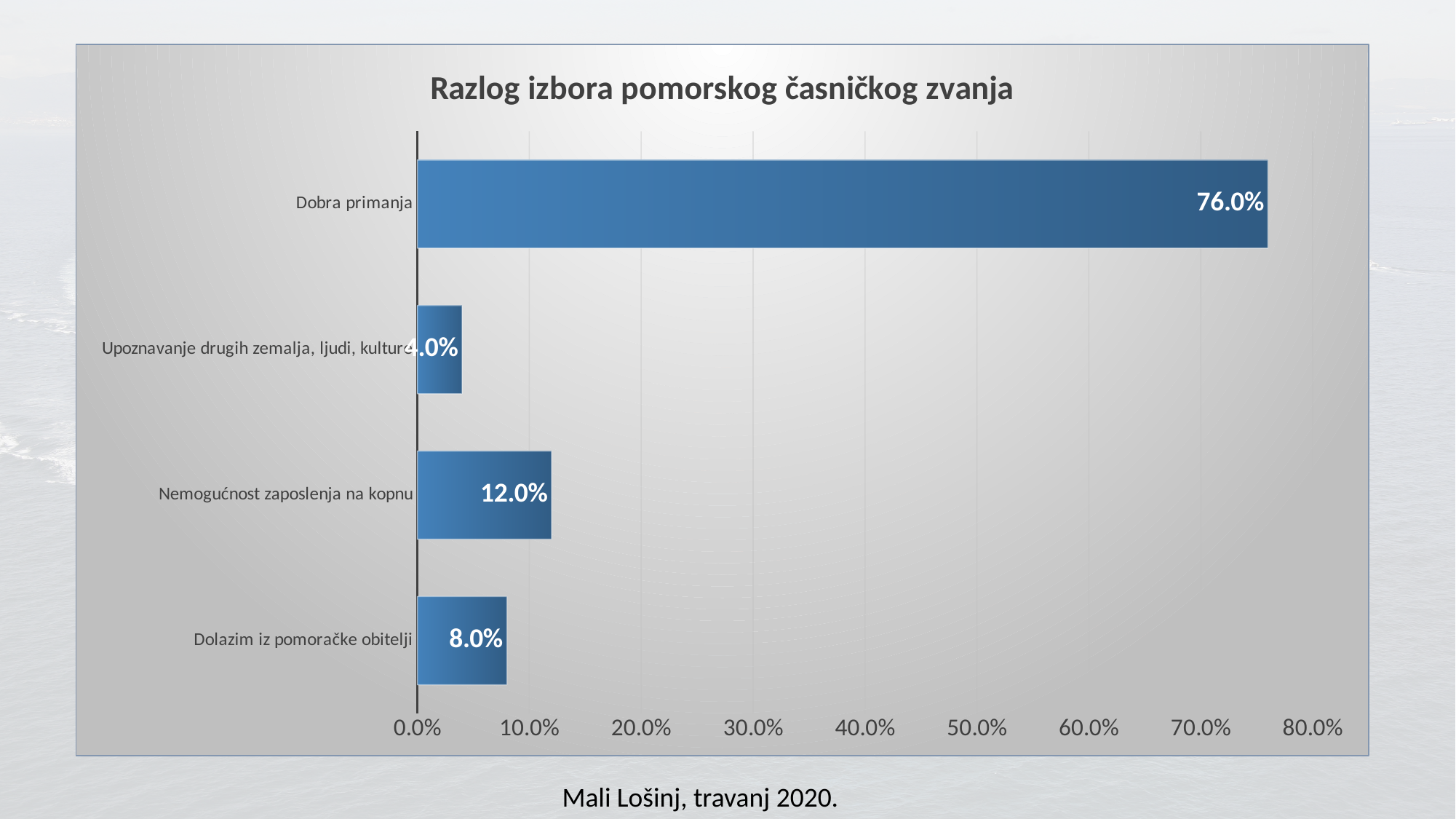
Which category has the highest value? Dobra primanja Which is larger, the value for Nemogućnost zaposlenja na kopnu or the value for Dolazim iz pomoračke obitelji? Nemogućnost zaposlenja na kopnu What kind of chart is shown on the slide? bar chart What is the difference between the values for Dobra primanja and Nemogućnost zaposlenja na kopnu? 64.0% What is the title of the chart? Razlog izbora pomorskog časničkog zvanja What is the value for Upoznavanje drugih zemalja, ljudi, kulture? 4.0% Which category has the lowest value? Upoznavanje drugih zemalja, ljudi, kulture Is the value for Dobra primanja greater or less than 70.0%? greater How many categories are shown in the chart? 4 What is the value for Nemogućnost zaposlenja na kopnu? 12.0% What is the value for Dobra primanja? 76.0% What is the value for Dolazim iz pomoračke obitelji? 8.0%